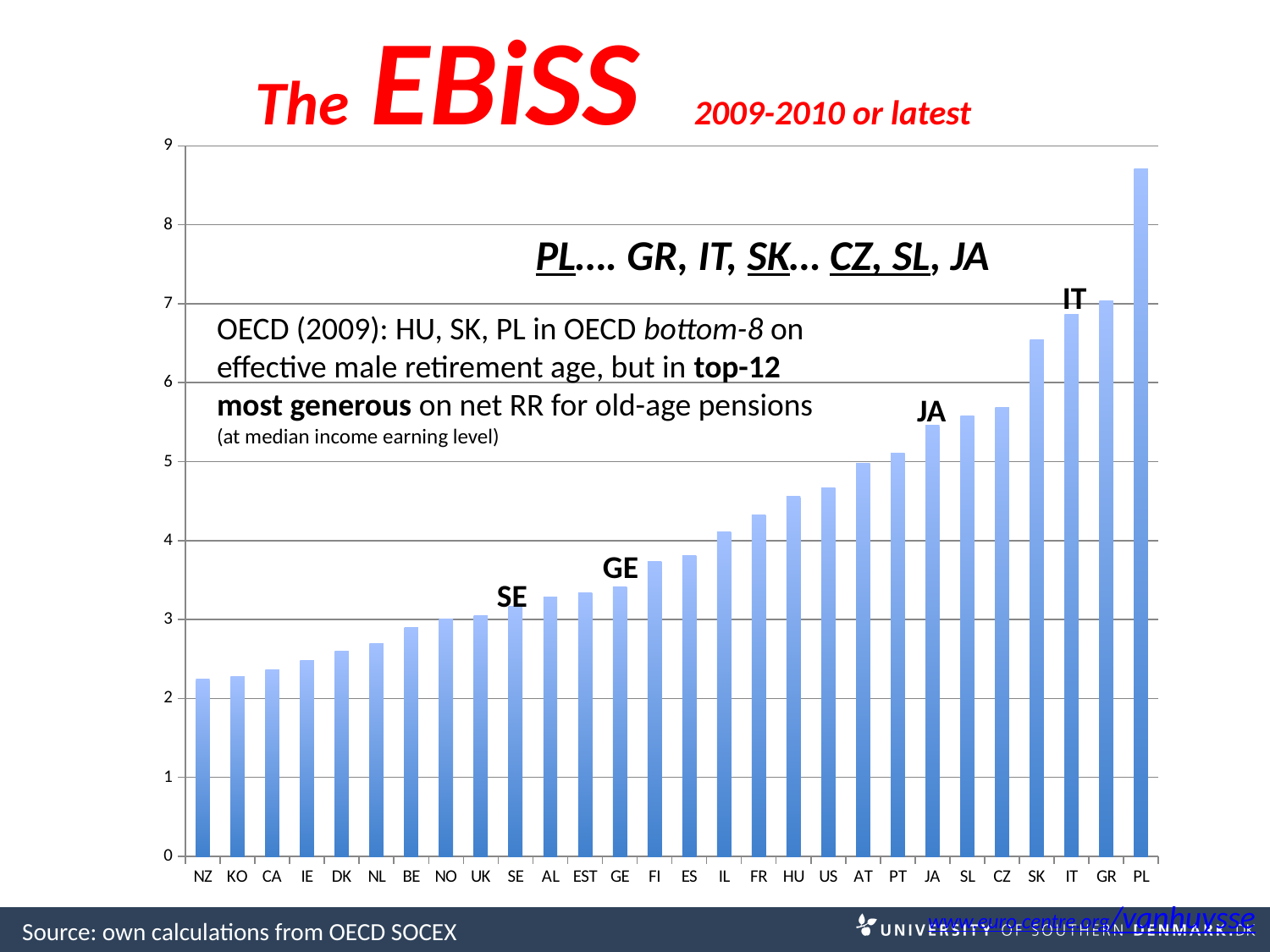
Is the value for JA greater or less than 5? greater Is the value for IT greater or less than 6? greater Which country has the lowest bar in the chart? NZ What kind of chart is shown on the slide? bar chart Do the bar values rise or fall moving from left to right along the x axis? rise What is the time period stated next to the chart title? 2009-2010 or latest Is the value for PL greater or less than 8? greater Which has the larger value, IT or JA? IT How many countries are plotted along the x axis? 28 Which country has the highest bar in the chart? PL